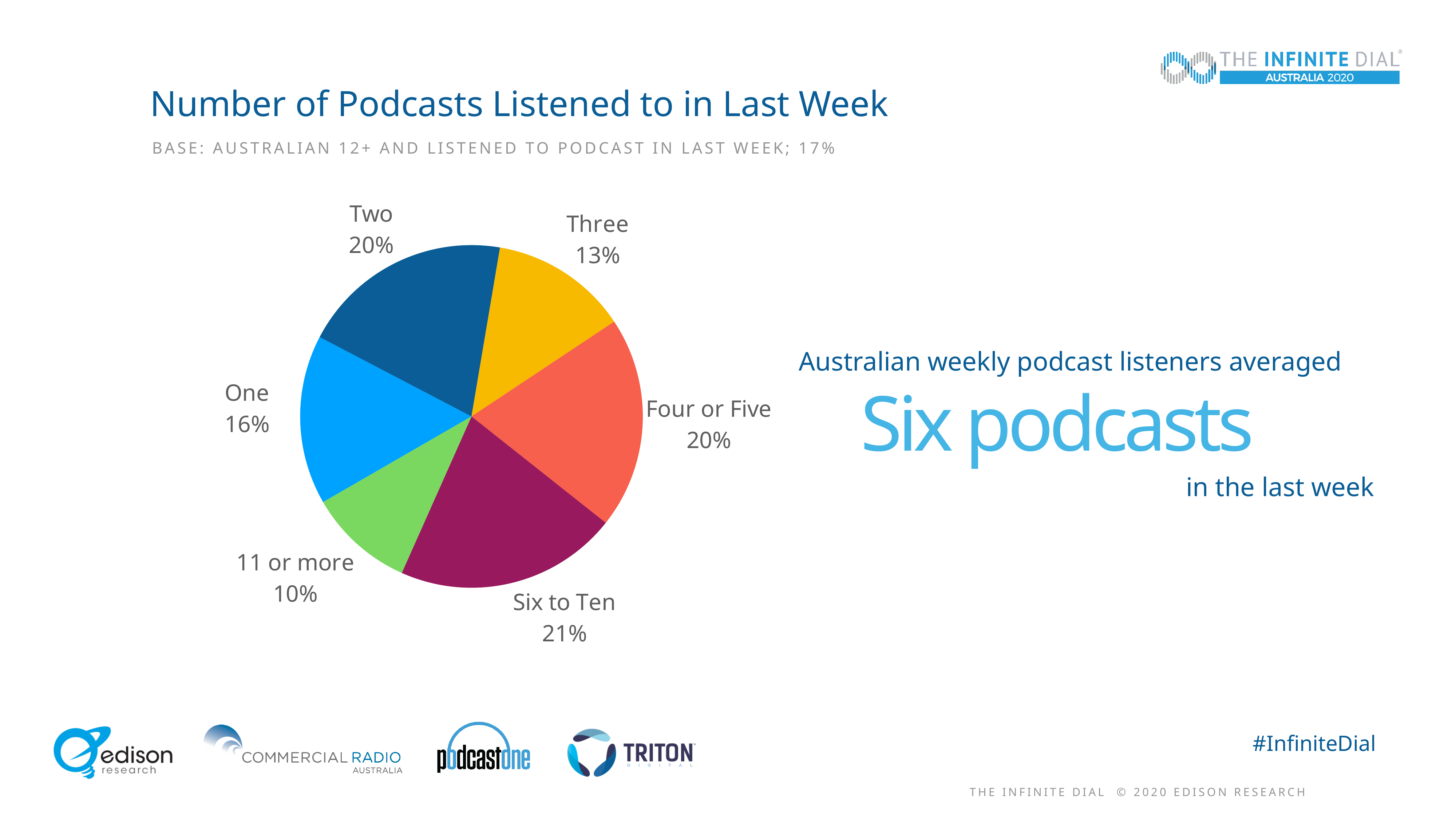
Which category has the largest share of the pie? Six to Ten What kind of chart is shown on the slide? Pie chart What share of the pie is labelled 'Six to Ten'? 21% What is the value shown for the 'One' slice? 16% Which is larger, the share for 'One' or the share for 'Three'? One What percentage of weekly podcast listeners listened to two podcasts in the last week? 20% How many categories are shown in the pie chart? 6 What colour is the 'Four or Five' slice? Orange-red Which category has the smallest share of the pie? 11 or more What percentage is shown for 'Three'? 13% What is the difference in percentage points between 'Six to Ten' and '11 or more'? 11 What is the title of the chart? Number of Podcasts Listened to in Last Week